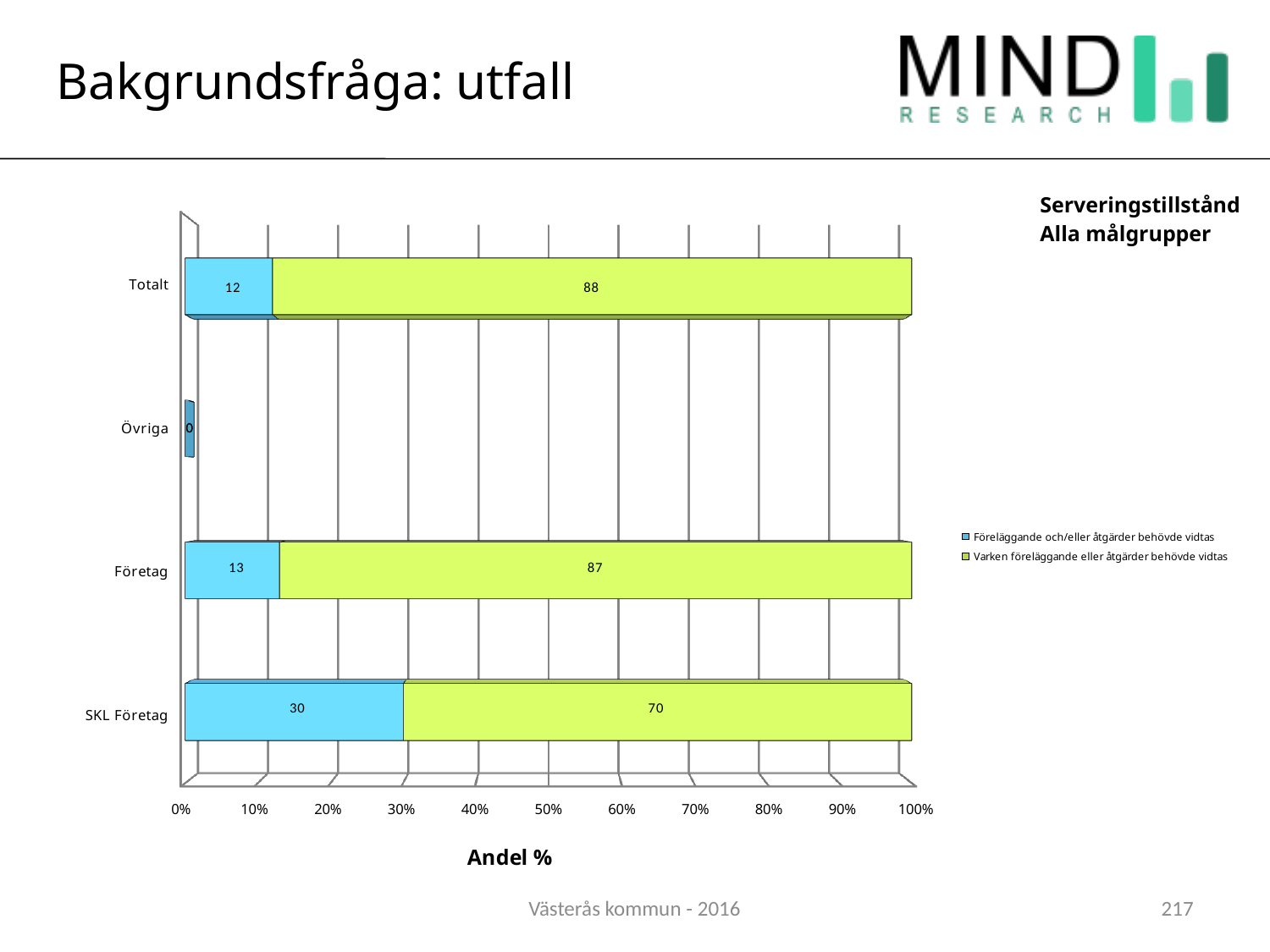
How many categories are shown on the vertical axis? 4 Which is larger: the 'Föreläggande och/eller åtgärder behövde vidtas' value for Totalt or for Företag? Företag Which category has the highest value for 'Föreläggande och/eller åtgärder behövde vidtas'? SKL Företag Which category has the lowest value for 'Varken föreläggande eller åtgärder behövde vidtas' among Totalt, Företag and SKL Företag? SKL Företag What is the value for 'Varken föreläggande eller åtgärder behövde vidtas' for Totalt? 88 What is the value for 'Föreläggande och/eller åtgärder behövde vidtas' for Företag? 13 What is the value for 'Föreläggande och/eller åtgärder behövde vidtas' for SKL Företag? 30 What value is labelled for Övriga? 0 What is the difference between the 'Varken föreläggande eller åtgärder behövde vidtas' values for Företag and SKL Företag? 17 What is the value for 'Varken föreläggande eller åtgärder behövde vidtas' for SKL Företag? 70 How many series does the legend list? 2 What kind of chart is shown on the slide? Stacked bar chart